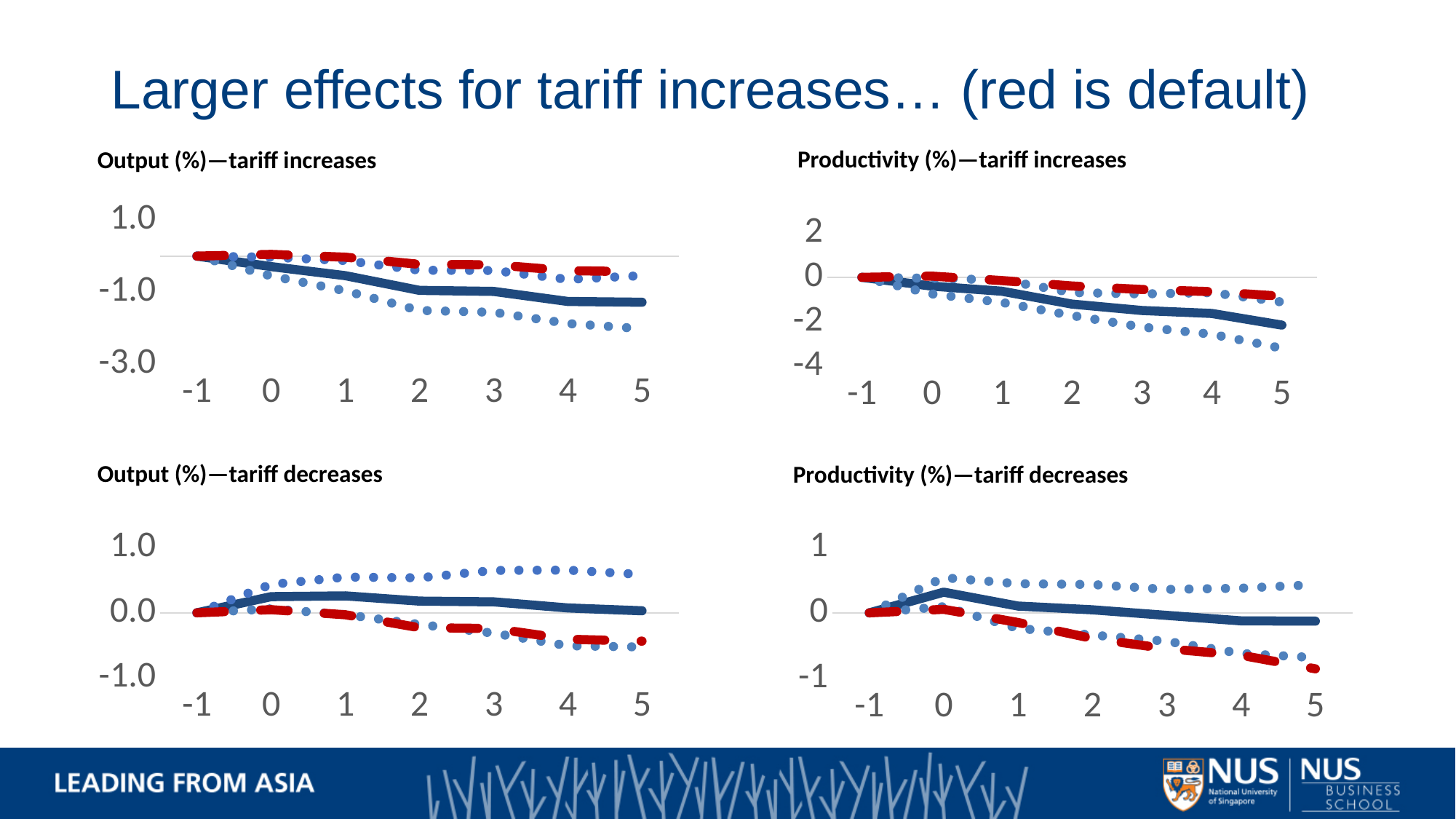
In the "Output (%)—tariff decreases" chart, is the value of the upper dotted blue line at x = 5 greater or less than 0.0? greater What kind of chart is the "Output (%)—tariff increases" chart? line chart In the "Productivity (%)—tariff decreases" chart, is the value of the red dashed line at x = 5 greater or less than 0? less In the "Productivity (%)—tariff decreases" chart, is the value of the upper dotted blue line at x = 5 greater or less than 0? greater According to the slide title, which colour represents the default specification in the charts? red In the "Output (%)—tariff increases" chart, does the solid blue line rise or fall as the x axis goes from -1 to 5? fall How many x-axis points are shown on the "Productivity (%)—tariff increases" chart? 7 In the "Output (%)—tariff decreases" chart, does the red dashed line rise or fall as the x axis goes from 0 to 5? fall What is the title of the chart in the bottom-right position of the slide? Productivity (%)—tariff decreases